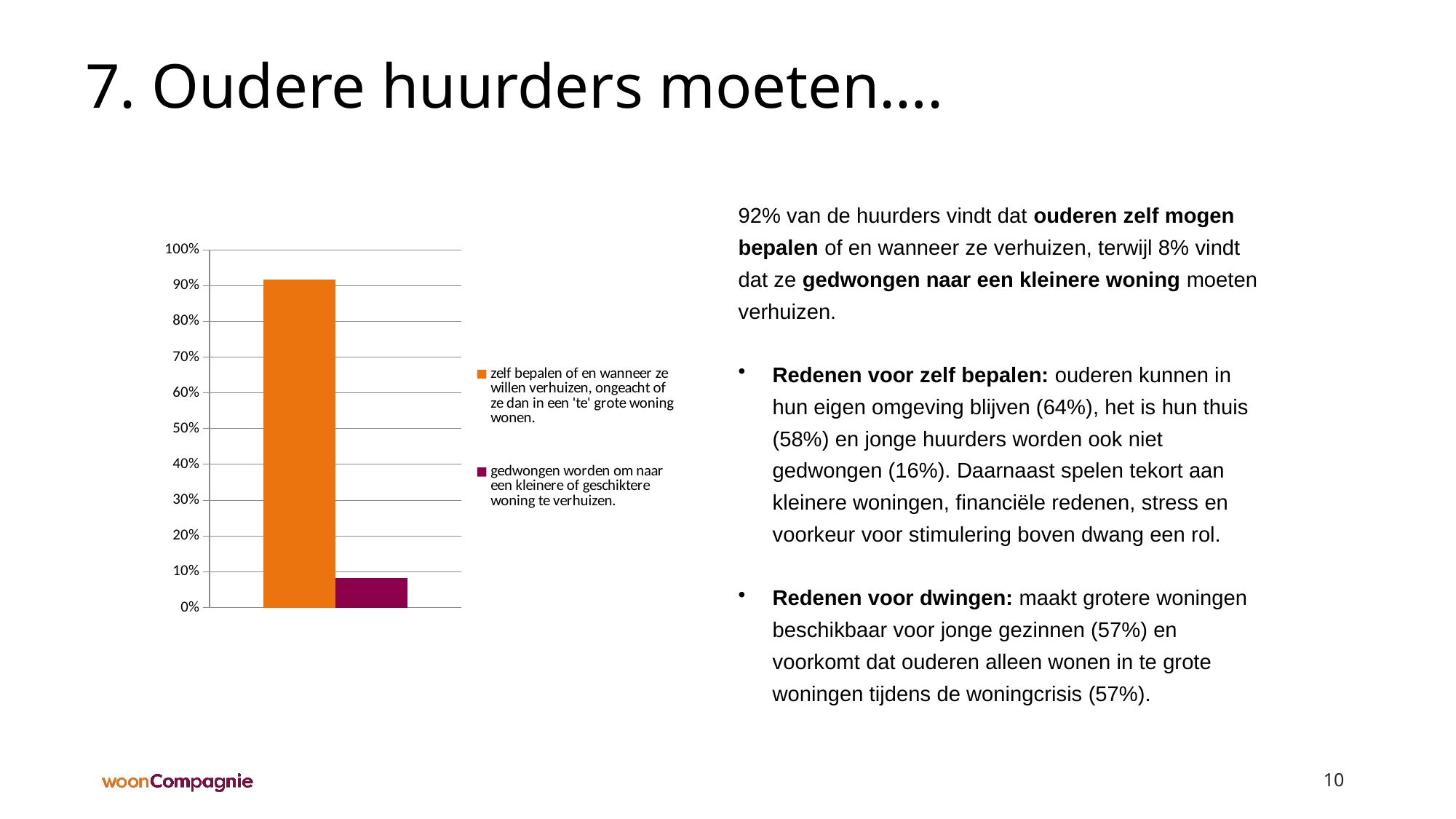
Is the value for 'gedwongen worden om naar een kleinere of geschiktere woning te verhuizen' greater or less than 50%? less What kind of chart is shown on the slide? bar chart Is the value for 'gedwongen worden om naar een kleinere of geschiktere woning te verhuizen' greater or less than 20%? less What is the highest value shown on the chart's vertical axis? 100% What colour is the bar for 'zelf bepalen of en wanneer ze willen verhuizen'? orange Which bar is taller: the one for 'zelf bepalen' or the one for 'gedwongen worden'? zelf bepalen How many bars are plotted in the chart? 2 Which series has the lowest bar in the chart? gedwongen worden om naar een kleinere of geschiktere woning te verhuizen. How many series does the chart legend list? 2 Which series has the highest bar in the chart? zelf bepalen of en wanneer ze willen verhuizen, ongeacht of ze dan in een 'te' grote woning wonen. Is the value for 'zelf bepalen of en wanneer ze willen verhuizen' greater or less than 80%? greater